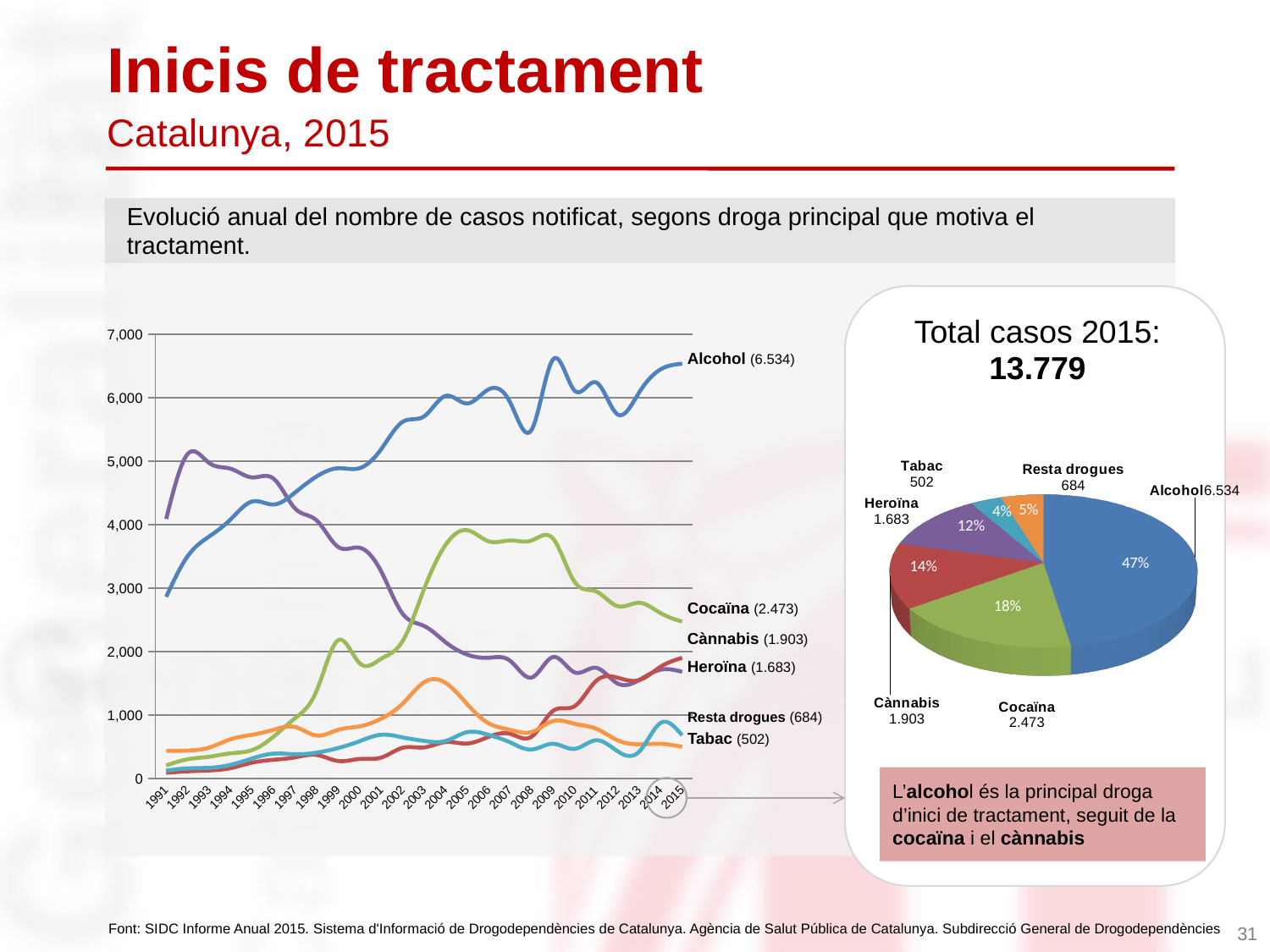
In the line chart on the left, how many years are shown on the x axis? 25 In the line chart on the left, which drug has the highest number of cases in 2015? Alcohol In the line chart on the left, what is the value shown for Alcohol in 2015? 6.534 What kind of chart is the chart on the left of the slide? line chart In the line chart on the left, is the value for Alcohol in 2000 greater or less than 4,000? greater In the pie chart on the right, what share of cases does Alcohol represent? 47% In the line chart on the left, what is the value shown for Cocaïna in 2015? 2.473 In the line chart on the left, what is the difference between the 2015 values for Alcohol and Cocaïna? 4.061 In the line chart on the left, which drug has the lowest number of cases in 2015? Tabac In the pie chart on the right, how many slices are there? 6 In the line chart on the left, which is larger in 2015: Cànnabis or Heroïna? Cànnabis In the line chart on the left, does the Heroïna line rise or fall between 1992 and 2015? fall